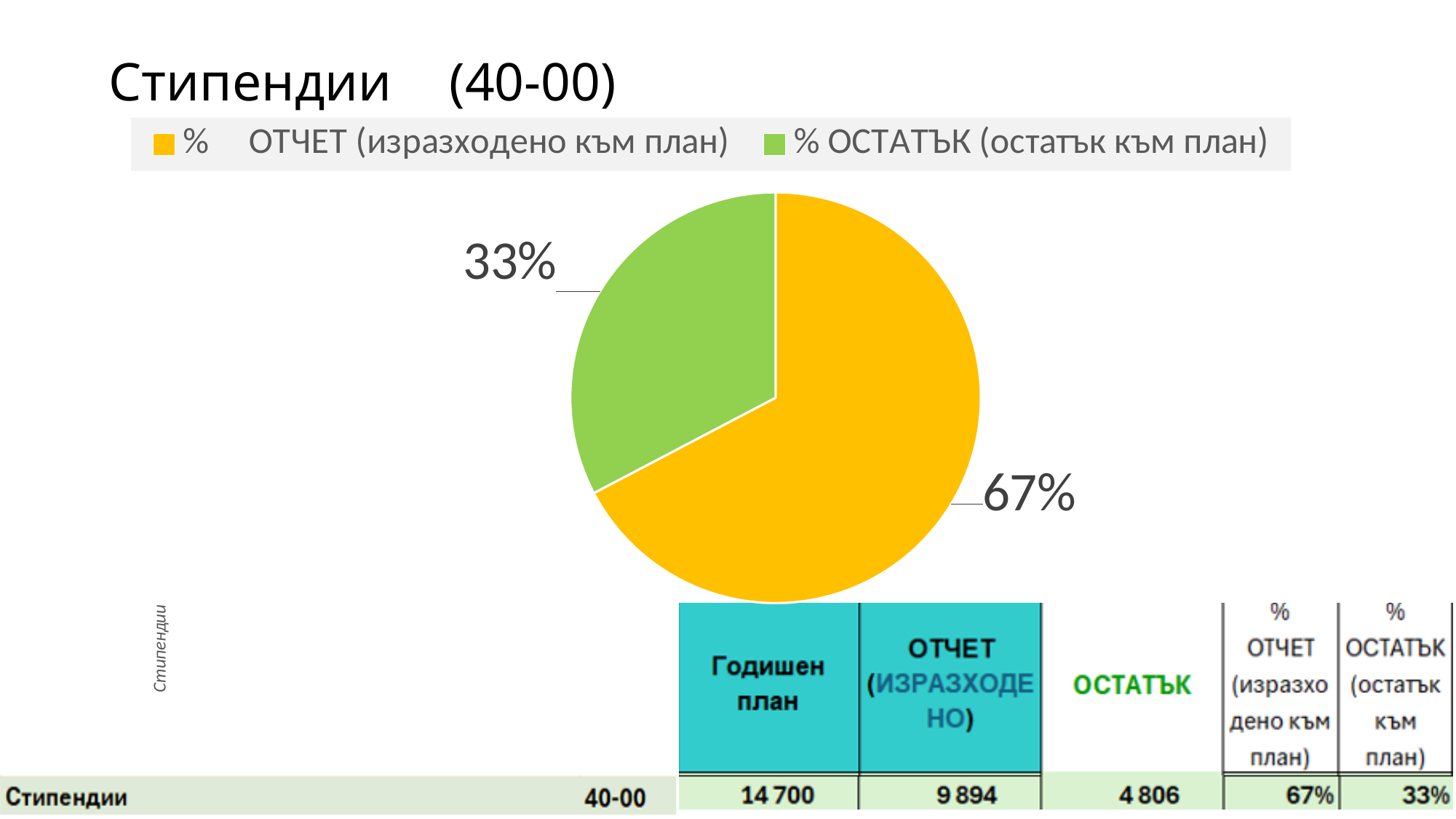
What colour is the "% ОСТАТЪК (остатък към план)" slice? green Which slice of the pie is the largest? % ОТЧЕТ (изразходено към план) How many slices does the pie chart have? 2 Which slice of the pie is the smallest? % ОСТАТЪК (остатък към план) Is the share of the "% ОТЧЕТ (изразходено към план)" slice greater or less than 50%? greater What share of the pie does the "% ОСТАТЪК (остатък към план)" slice represent? 33% What is the difference in percentage points between the "% ОТЧЕТ" slice and the "% ОСТАТЪК" slice? 34 Which is larger, the "% ОТЧЕТ (изразходено към план)" slice or the "% ОСТАТЪК (остатък към план)" slice? % ОТЧЕТ (изразходено към план) What share of the pie does the "% ОТЧЕТ (изразходено към план)" slice represent? 67% How many entries does the legend list? 2 What is the title of the slide containing the pie chart? Стипендии (40-00) What kind of chart is shown on the slide? pie chart